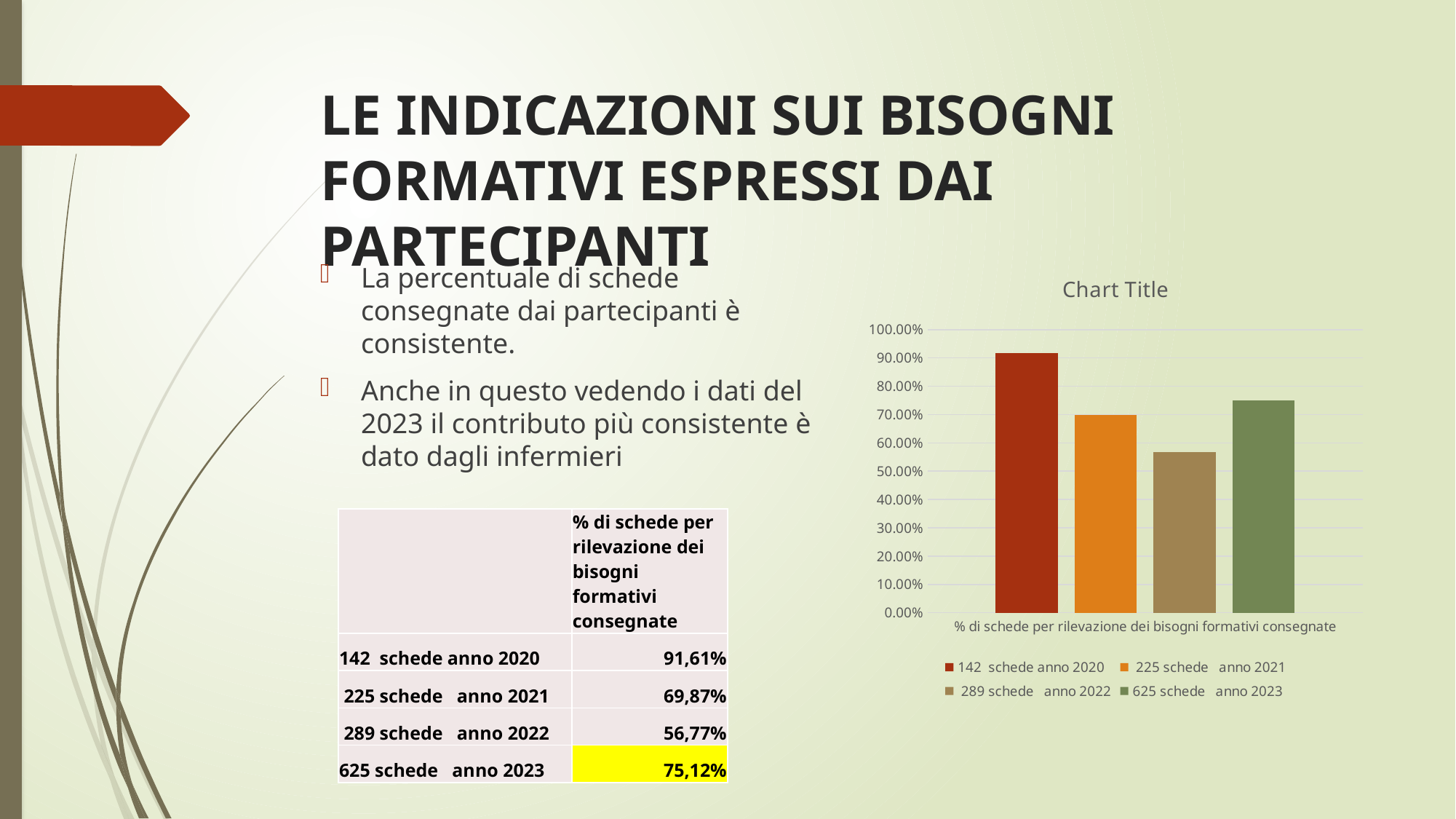
What kind of chart is shown on the slide? bar chart Is the bar for 625 schede anno 2023 greater or less than 70.00%? greater How many series does the chart legend list? 4 Which series has the tallest bar in the chart? 142 schede anno 2020 Is the bar for 289 schede anno 2022 greater or less than 60.00%? less Which series has the shortest bar in the chart? 289 schede anno 2022 What is the title of the chart? Chart Title According to the table on the slide, what percentage of schede was consegnate for 625 schede anno 2023? 75,12% Which bar is taller: 225 schede anno 2021 or 625 schede anno 2023? 625 schede anno 2023 What colour is the bar for 625 schede anno 2023? green According to the table on the slide, what percentage of schede was consegnate for 142 schede anno 2020? 91,61% Is the bar for 142 schede anno 2020 greater or less than 90.00%? greater